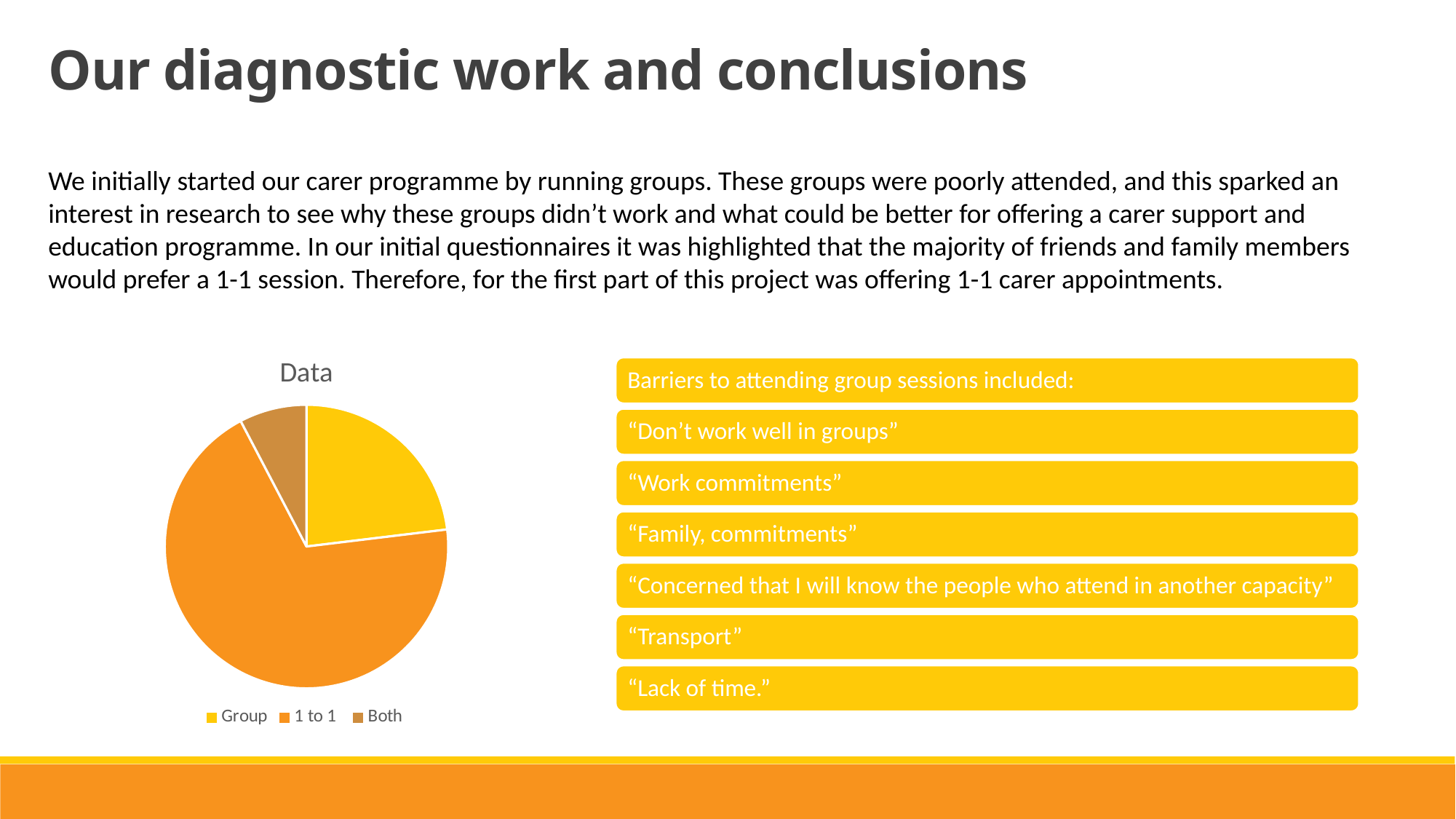
What are the three categories listed in the legend? Group, 1 to 1, Both What is the title of the chart? Data Which slice is larger, Group or Both? Group Which category has the largest slice of the pie? 1 to 1 Which category has the smallest slice of the pie? Both How many entries does the chart legend list? 3 How many slices does the pie chart have? 3 What kind of chart is shown on the slide? pie chart Which slice is larger, 1 to 1 or Group? 1 to 1